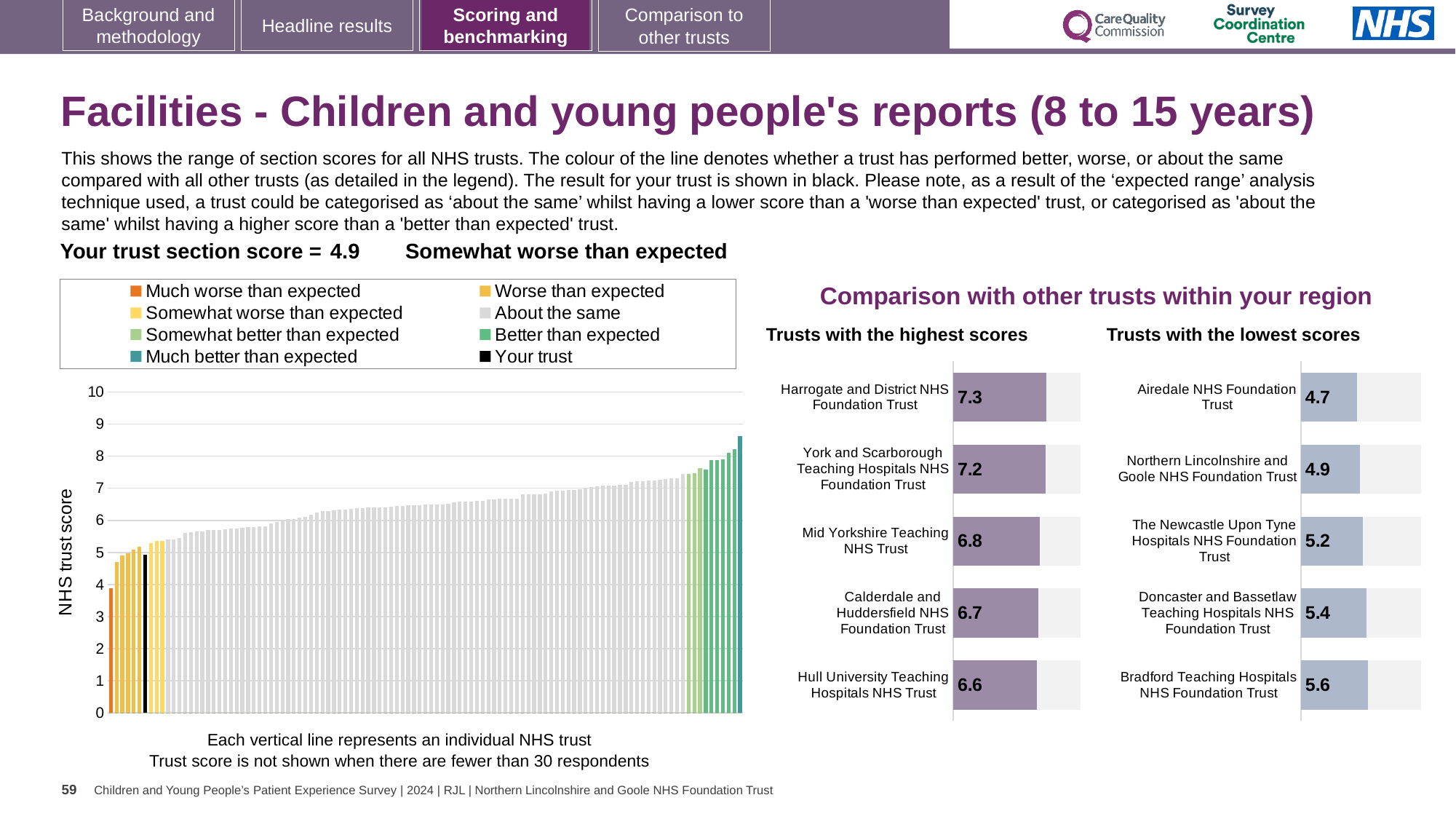
In the 'Trusts with the lowest scores' chart, what is the difference between the scores of Bradford Teaching Hospitals NHS Foundation Trust and Airedale NHS Foundation Trust? 0.9 In the 'Trusts with the lowest scores' chart, what is the score for Doncaster and Bassetlaw Teaching Hospitals NHS Foundation Trust? 5.4 In the 'Trusts with the highest scores' chart, what is the score for Harrogate and District NHS Foundation Trust? 7.3 How many entries does the legend of the 'NHS trust score' chart list? 8 In the 'Trusts with the lowest scores' chart, which trust has the highest score? Bradford Teaching Hospitals NHS Foundation Trust In the 'Trusts with the highest scores' chart, what is the difference between the scores of Harrogate and District NHS Foundation Trust and Hull University Teaching Hospitals NHS Trust? 0.7 What kind of chart is the large 'NHS trust score' chart on the left of the slide? Bar chart In the 'Trusts with the highest scores' chart, what is the score for Mid Yorkshire Teaching NHS Trust? 6.8 Which is larger: the score for York and Scarborough Teaching Hospitals NHS Foundation Trust in the highest scores chart, or the score for The Newcastle Upon Tyne Hospitals NHS Foundation Trust in the lowest scores chart? York and Scarborough Teaching Hospitals NHS Foundation Trust In the 'Trusts with the lowest scores' chart, what is the score for Airedale NHS Foundation Trust? 4.7 How many trusts are shown in the 'Trusts with the lowest scores' chart? 5 In the 'Trusts with the highest scores' chart, which trust has the lowest score? Hull University Teaching Hospitals NHS Trust